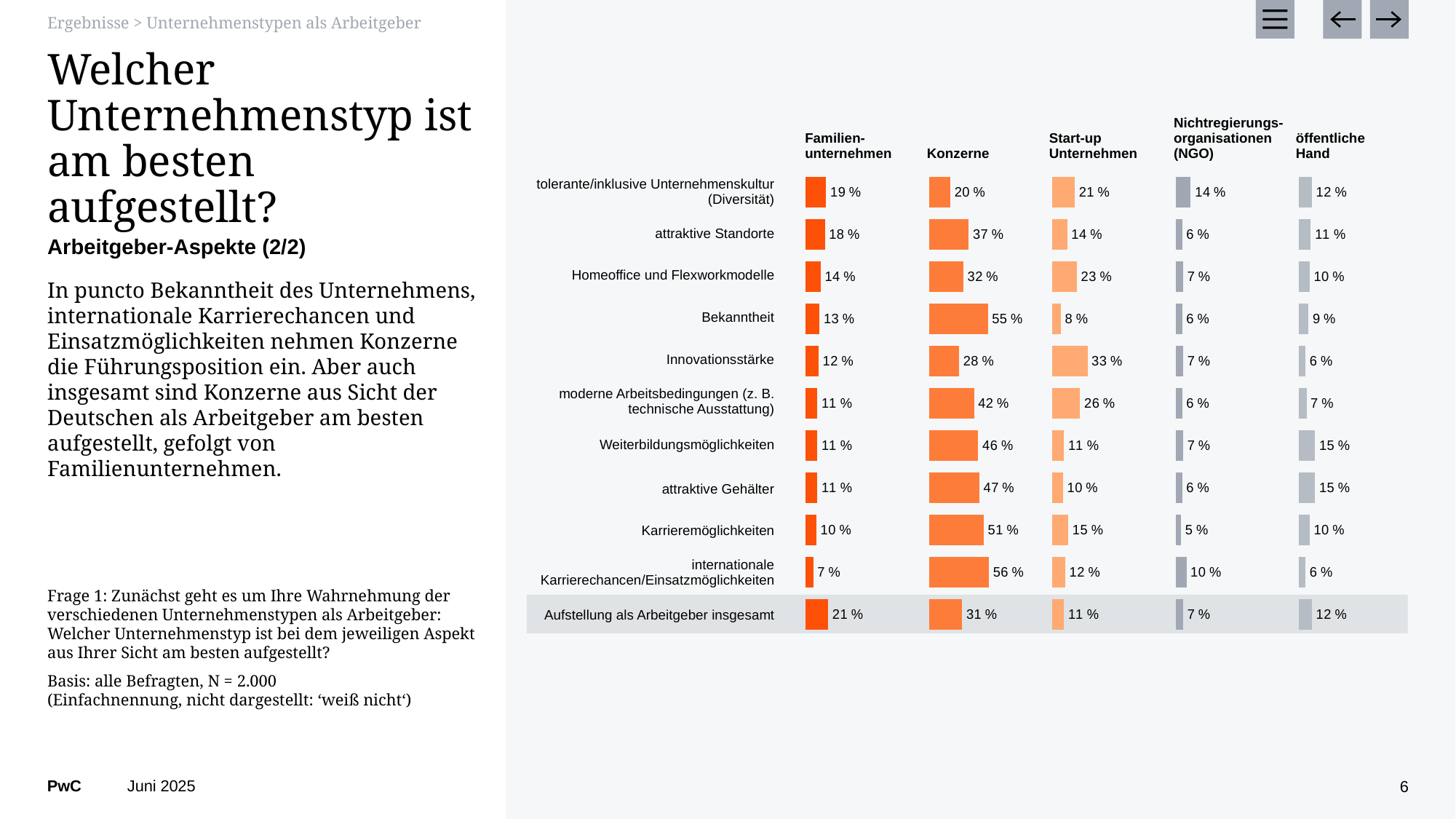
Which company type has the lowest value for Karrieremöglichkeiten? Nichtregierungsorganisationen (NGO) What is the difference between Konzerne and Familienunternehmen for attraktive Gehälter? 36 % What is the value for öffentliche Hand in the row Weiterbildungsmöglichkeiten? 15 % What is the value for Familienunternehmen in the row Aufstellung als Arbeitgeber insgesamt? 21 % How many company types (columns) are compared in the chart? 5 For Homeoffice und Flexworkmodelle, which is larger: Konzerne or Start-up Unternehmen? Konzerne What type of chart is shown on the slide? bar chart Which company type has the highest value for internationale Karrierechancen/Einsatzmöglichkeiten? Konzerne Which aspect has the lowest value in the Familienunternehmen column? internationale Karrierechancen/Einsatzmöglichkeiten What percentage of respondents chose Konzerne as best positioned for Bekanntheit? 55 % How many aspects (rows) are shown in the chart? 11 What is the value for Start-up Unternehmen in the row Innovationsstärke? 33 %